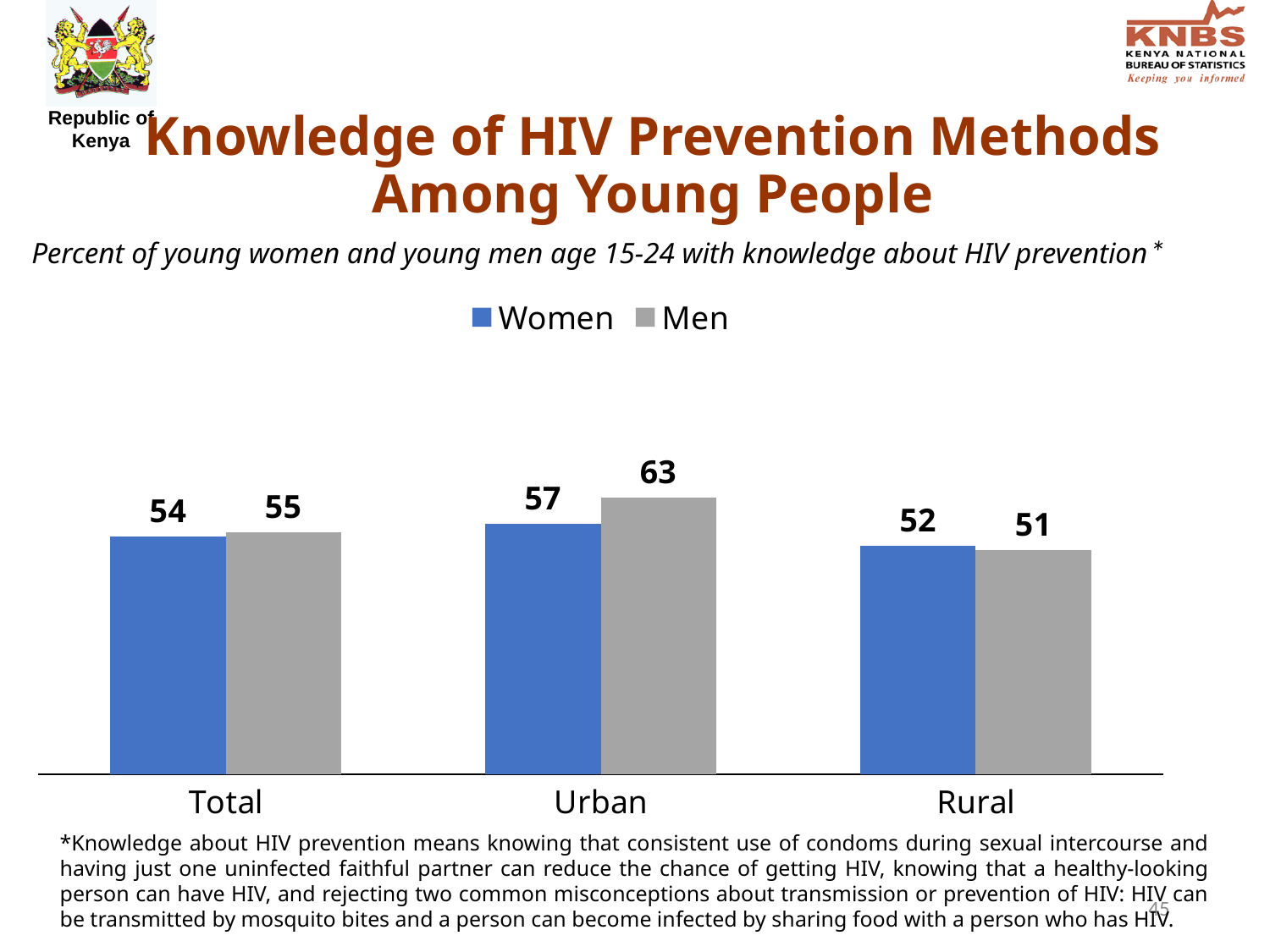
How many series does the legend list? 2 What is the difference between the Women values for Urban and Rural? 5 What kind of chart is shown on the slide? Bar chart Which category has the lowest value for Women? Rural What is the value for Men in the Rural category? 51 What is the value for Women in the Urban category? 57 What is the value for Men in the Total category? 55 What is the difference between the Men and Women values in the Urban category? 6 Which category has the highest value for Men? Urban In the Rural category, which is larger, the value for Women or the value for Men? Women What colour are the bars for the Women series? Blue How many categories are shown on the x axis? 3